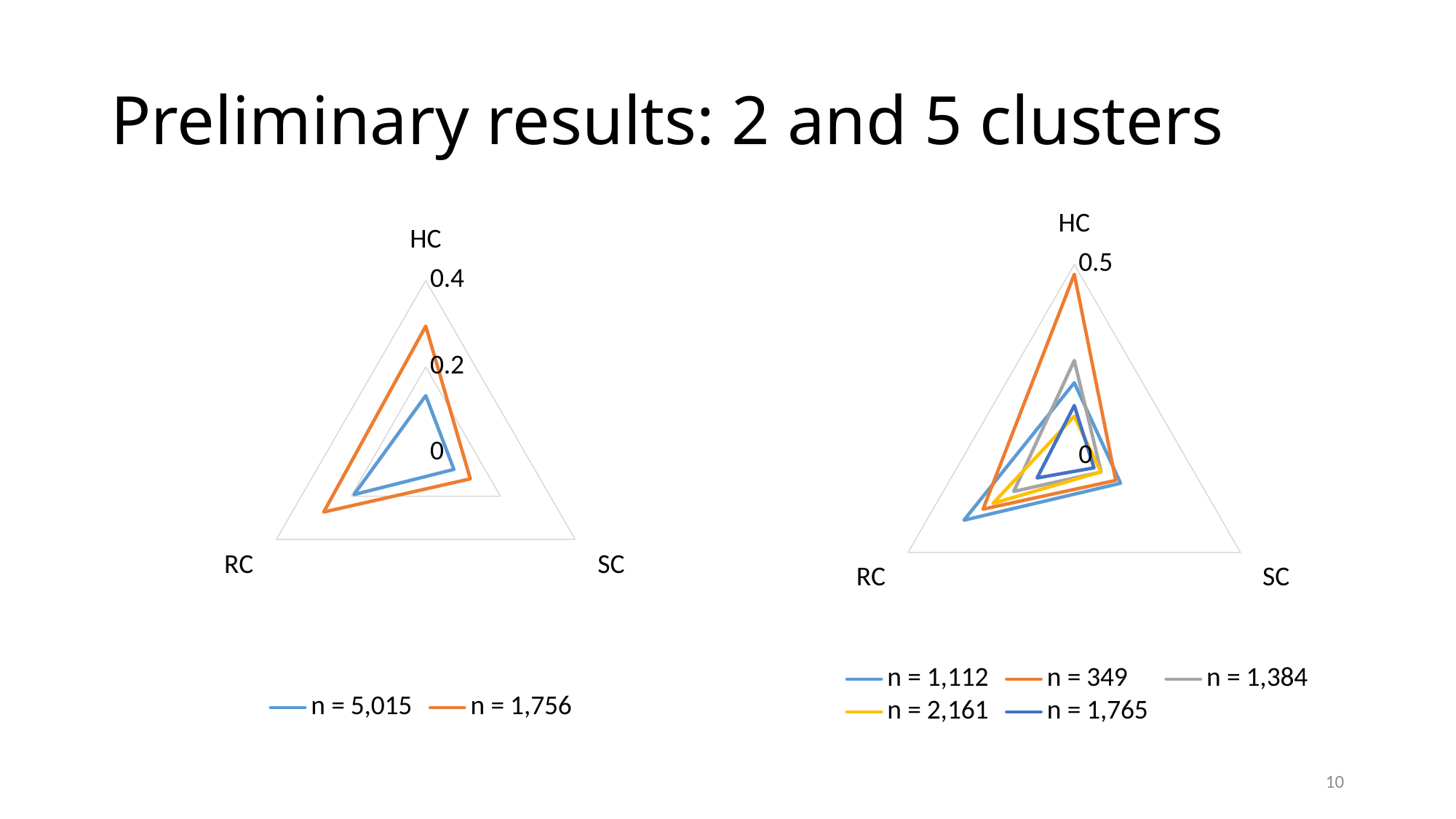
What is the maximum value shown on the axis scale of the right chart? 0.5 What kind of chart is the left chart on the slide? Radar chart How many series does the legend of the right chart list? 5 How many categories (axes) does the left chart have? 3 In the left chart, is the HC value for n = 5,015 greater or less than 0.2? less In the left chart, which series has the larger HC value, n = 5,015 or n = 1,756? n = 1,756 In the right chart, which series has the larger HC value, n = 349 or n = 1,384? n = 349 In the right chart, which series has the lowest HC value? n = 2,161 How many series does the legend of the left chart list? 2 In the right chart, which series has the highest HC value? n = 349 In the left chart, is the HC value for n = 1,756 greater or less than 0.2? greater What are the three axis labels on the right chart? HC, RC, SC